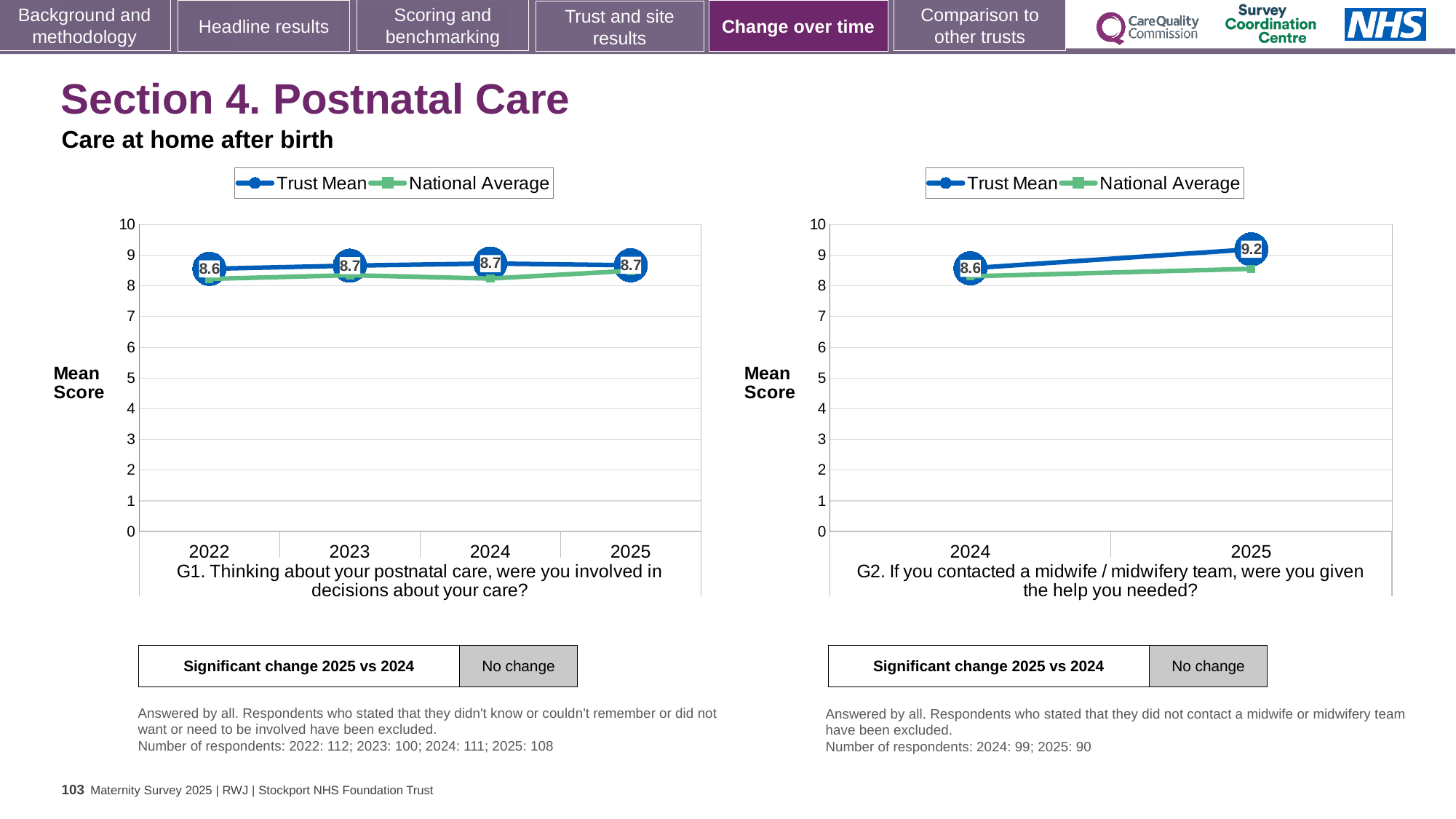
On the G1 chart (left), what is the Trust Mean for 2022? 8.6 On the G1 chart (left), what is the Trust Mean for 2025? 8.7 On the G2 chart (right), how many years are shown on the x axis? 2 On the G2 chart (right), what is the Trust Mean for 2025? 9.2 On the G2 chart (right), what is the difference between the Trust Mean for 2025 and 2024? 0.6 On the G2 chart (right), does the Trust Mean rise or fall from 2024 to 2025? Rise On the G1 chart (left), how many years are shown on the x axis? 4 What kind of chart is the G2 chart (right)? Line chart On the G2 chart (right), what is the Trust Mean for 2024? 8.6 How many series does the legend of the G1 chart (left) list? 2 On the G1 chart (left), is the National Average for 2022 greater or less than 5? greater On the G2 chart (right), which year has the higher Trust Mean, 2024 or 2025? 2025